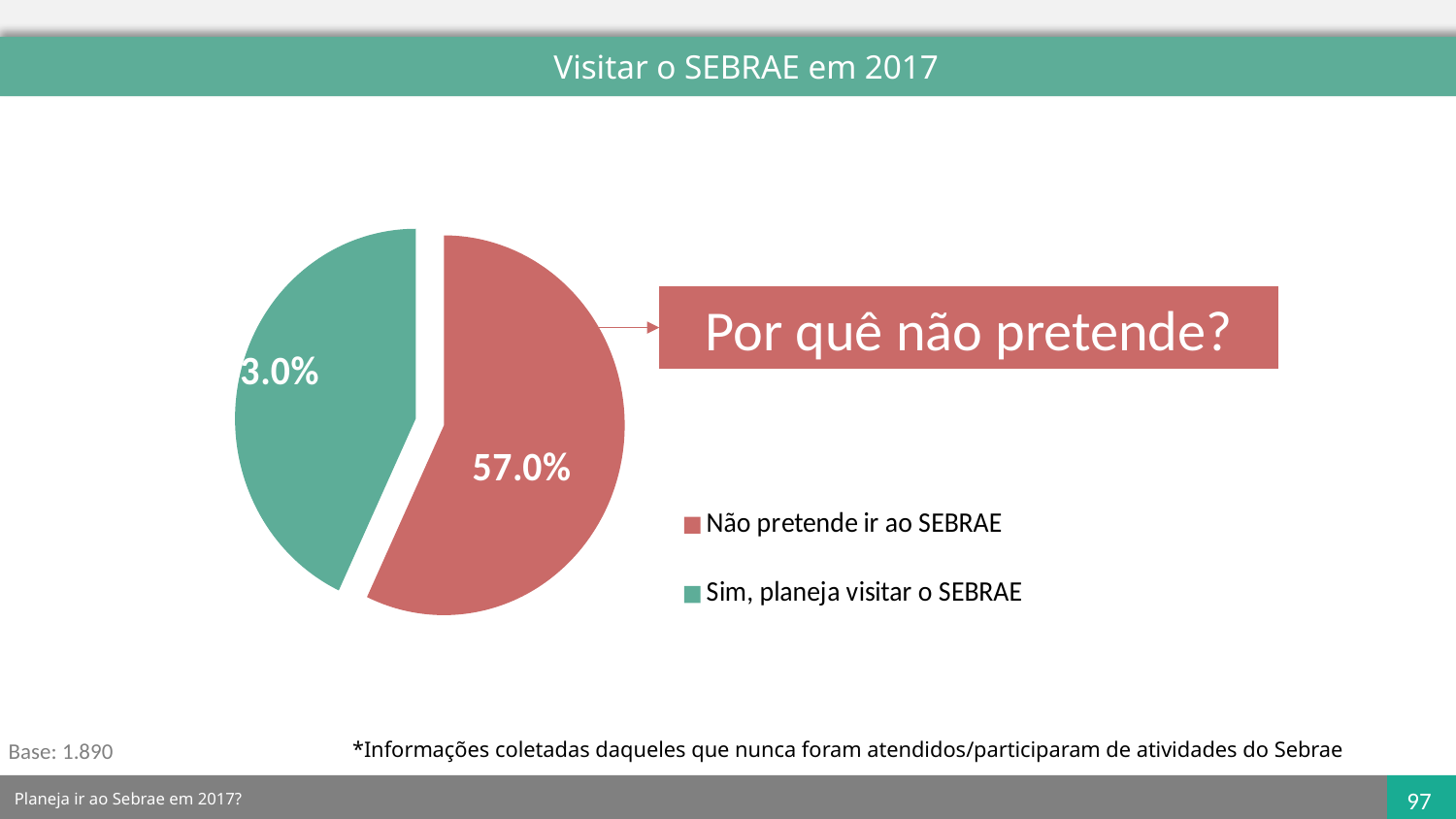
What percentage of the pie is labelled for "Não pretende ir ao SEBRAE"? 57.0% What is the title shown at the top of the slide above the chart? Visitar o SEBRAE em 2017 Which category has the smallest slice of the pie? Sim, planeja visitar o SEBRAE What colour is the slice for "Sim, planeja visitar o SEBRAE"? green Which slice is larger: "Não pretende ir ao SEBRAE" or "Sim, planeja visitar o SEBRAE"? Não pretende ir ao SEBRAE What share of the pie does "Não pretende ir ao SEBRAE" represent? 57.0% Which category has the largest slice of the pie? Não pretende ir ao SEBRAE How many slices does the pie chart have? 2 How many entries does the legend list? 2 Is the slice for "Não pretende ir ao SEBRAE" greater or less than 50% of the pie? greater What kind of chart is shown on the slide? pie chart